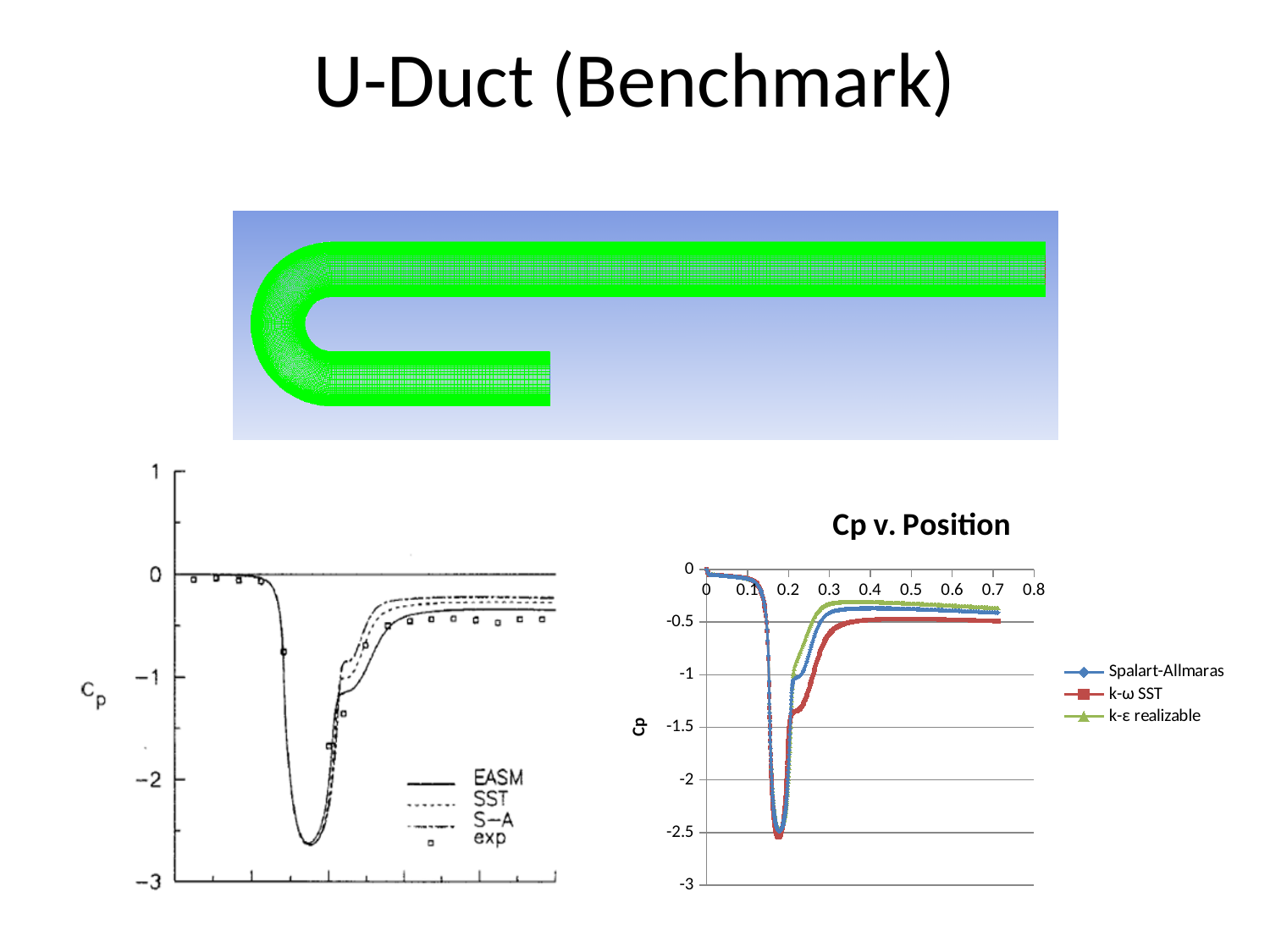
In the 'Cp v. Position' chart, do the values fall or rise between position 0.1 and position 0.2? fall What kind of chart is the 'Cp v. Position' chart? line chart In the 'Cp v. Position' chart, is the lowest value reached by the k-ω SST series greater or less than -2? less In the 'Cp v. Position' chart, which series is drawn in red with square markers? k-ω SST In the 'Cp v. Position' chart, which series has the lowest value at position 0.7? k-ω SST What is the title of the chart on the right of the slide? Cp v. Position How many entries does the legend of the chart on the left of the slide list? 4 In the 'Cp v. Position' chart, is the value of k-ε realizable at position 0.6 greater or less than -0.5? greater How many series does the legend of the 'Cp v. Position' chart list? 3 In the 'Cp v. Position' chart, at position 0.7, is the value for k-ε realizable larger or smaller than the value for k-ω SST? larger In the 'Cp v. Position' chart, do the values fall or rise between position 0.2 and position 0.3? rise In the 'Cp v. Position' chart, is the value of k-ω SST at position 0.2 greater or less than -1? less